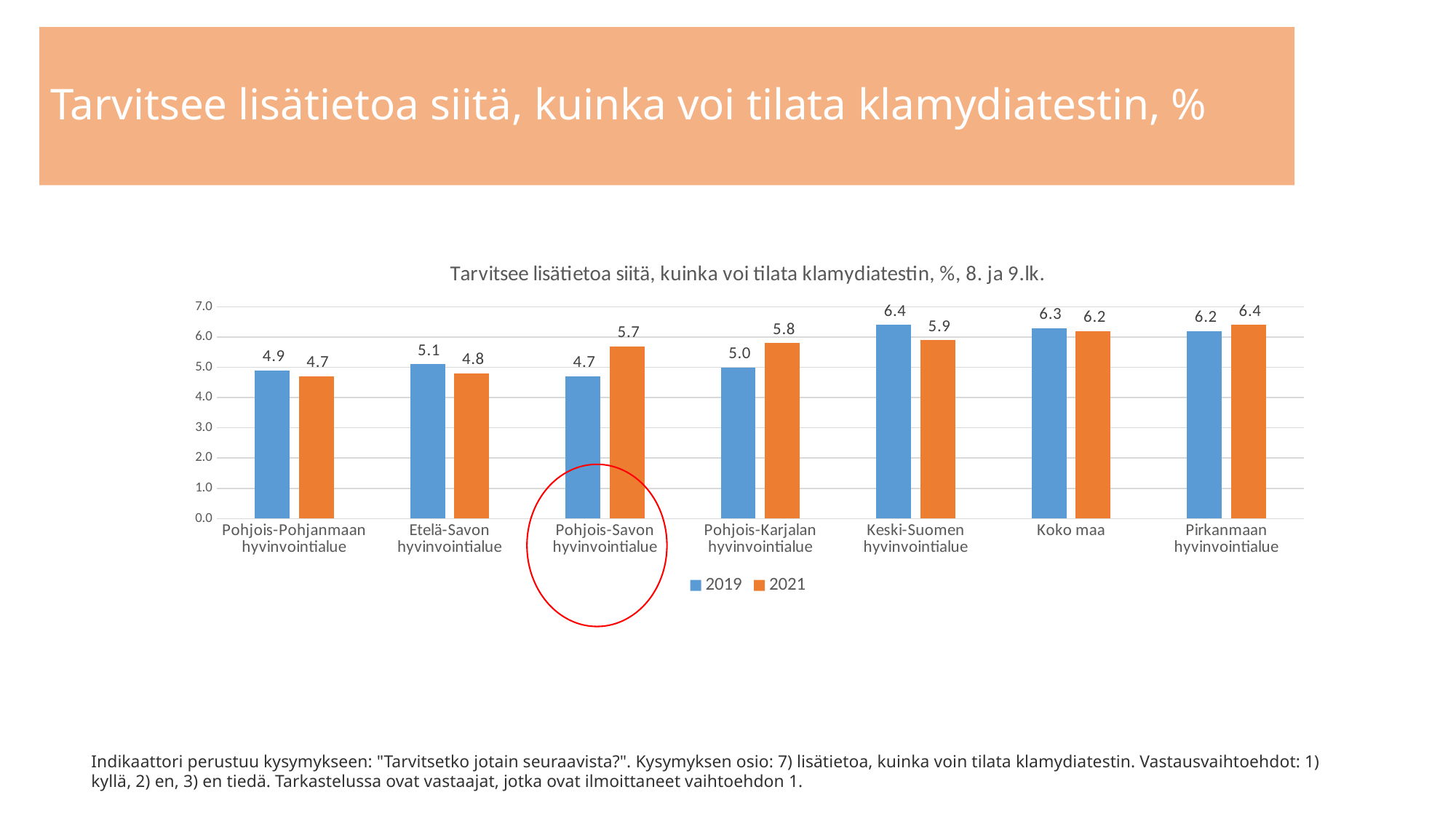
What is the 2021 value for Pohjois-Savon hyvinvointialue? 5.7 What is the 2019 value for Koko maa? 6.3 Which is larger for Etelä-Savon hyvinvointialue, the 2019 value or the 2021 value? 2019 How many categories are shown on the x axis? 7 Which colour represents the 2021 series? Orange Which category has the highest 2019 value? Keski-Suomen hyvinvointialue How many series does the legend list? 2 What kind of chart is shown on the slide? Bar chart Which category has the lowest 2019 value? Pohjois-Savon hyvinvointialue What is the difference between the 2021 and 2019 values for Pohjois-Savon hyvinvointialue? 1.0 What is the 2021 value for Pohjois-Karjalan hyvinvointialue? 5.8 Which category has the lowest 2021 value? Pohjois-Pohjanmaan hyvinvointialue